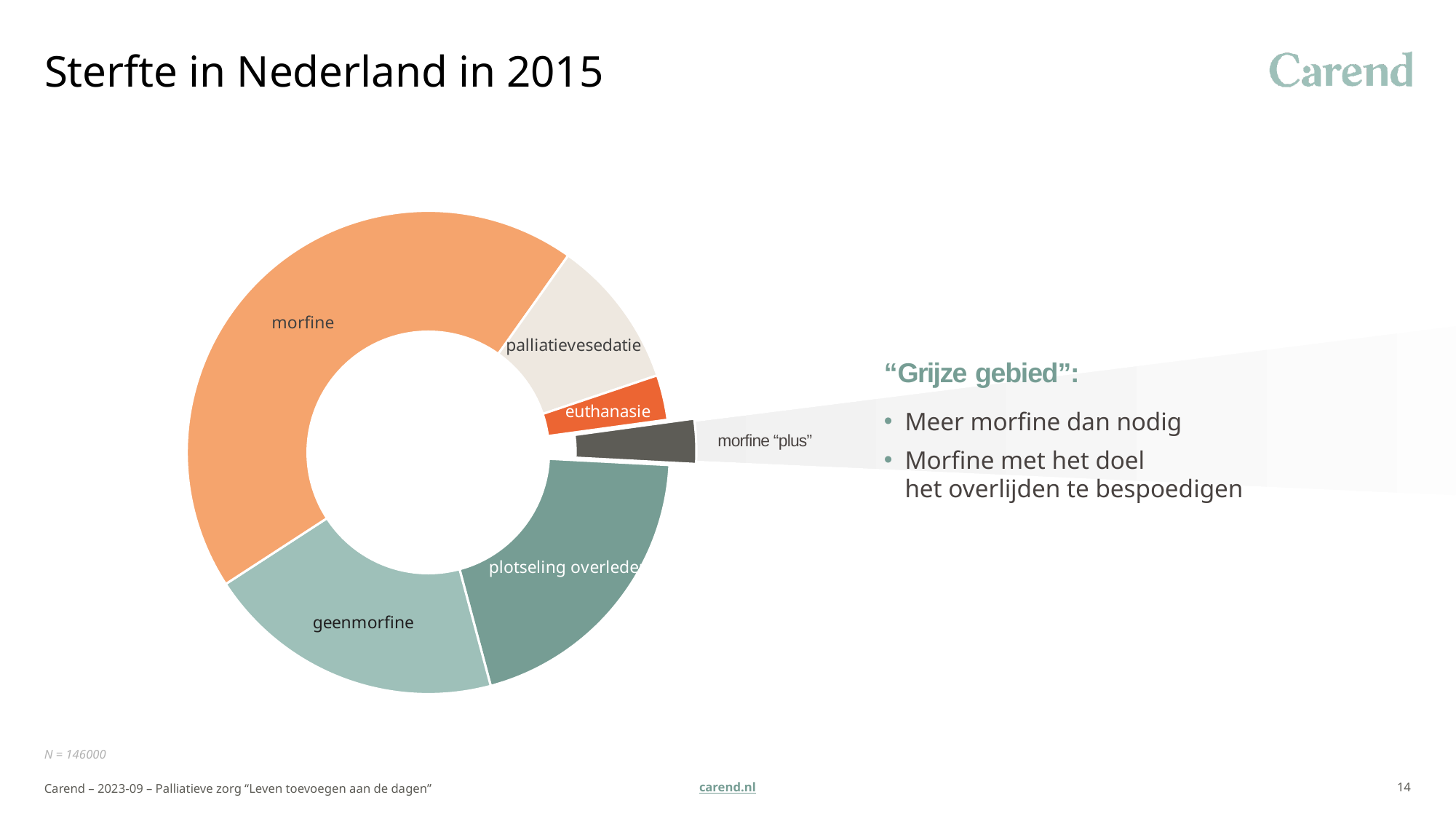
How many slices does the pie chart have? 6 What sample size (N) is noted below the pie chart? N = 146000 Which slice is larger, palliatievesedatie or euthanasie? palliatievesedatie Which slice is larger, plotseling overleden or euthanasie? plotseling overleden What is the title of the slide containing the pie chart? Sterfte in Nederland in 2015 Which slice is larger, geenmorfine or palliatievesedatie? geenmorfine What kind of chart is shown on the slide? Pie chart (donut) Which category has the largest slice in the pie chart? morfine